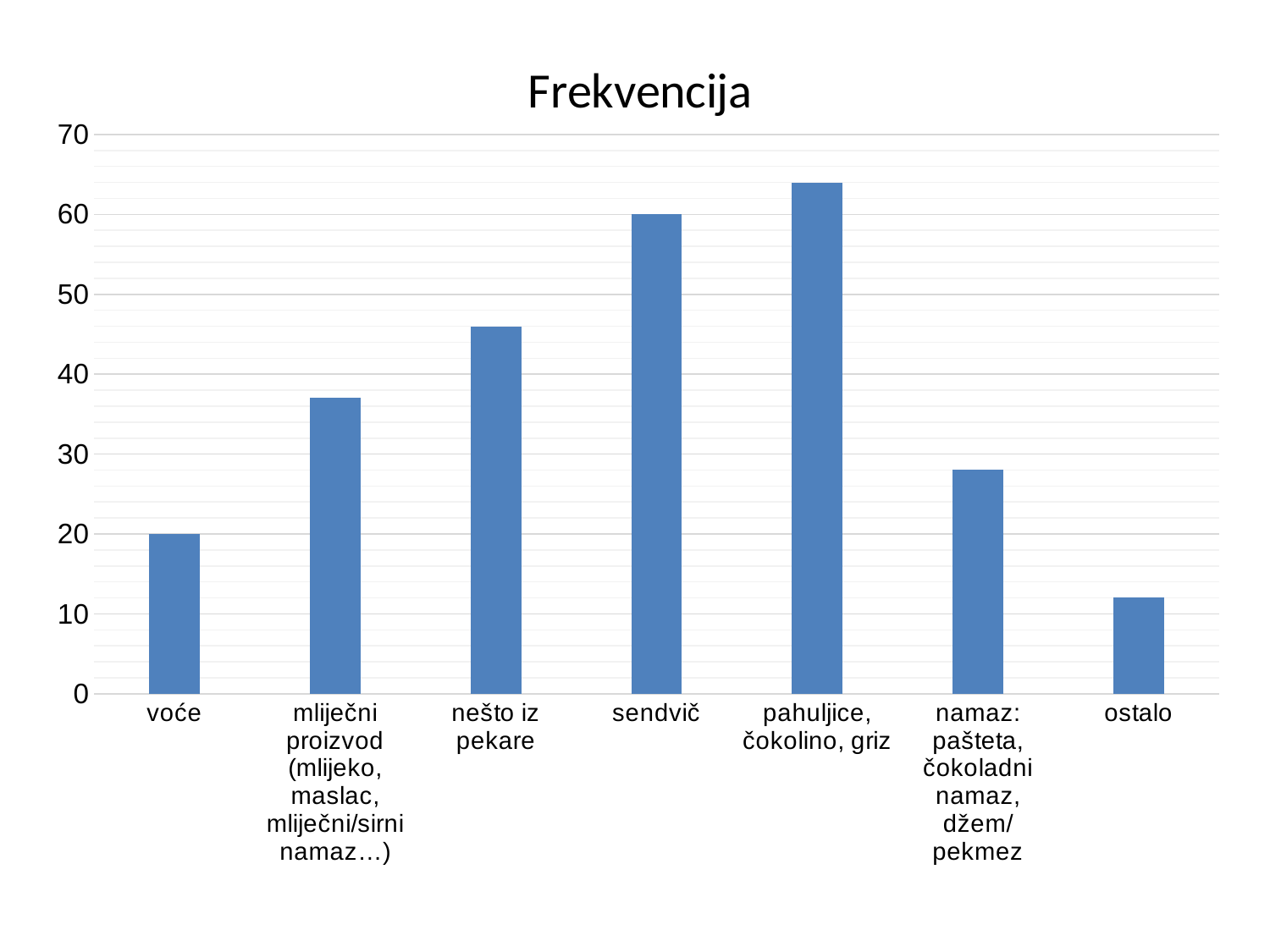
What is the title of the chart? Frekvencija Is the value for mliječni proizvod (mlijeko, maslac, mliječni/sirni namaz…) greater or less than 30? greater What is the value for sendvič? 60 Is the value for namaz: pašteta, čokoladni namaz, džem/pekmez greater or less than 30? less Is the value for nešto iz pekare greater or less than 40? greater Which is larger, the value for nešto iz pekare or the value for voće? nešto iz pekare Which category has the highest value? pahuljice, čokolino, griz What is the value for voće? 20 How many categories are shown on the x axis? 7 Which category has the lowest value? ostalo What kind of chart is shown on the slide? bar chart